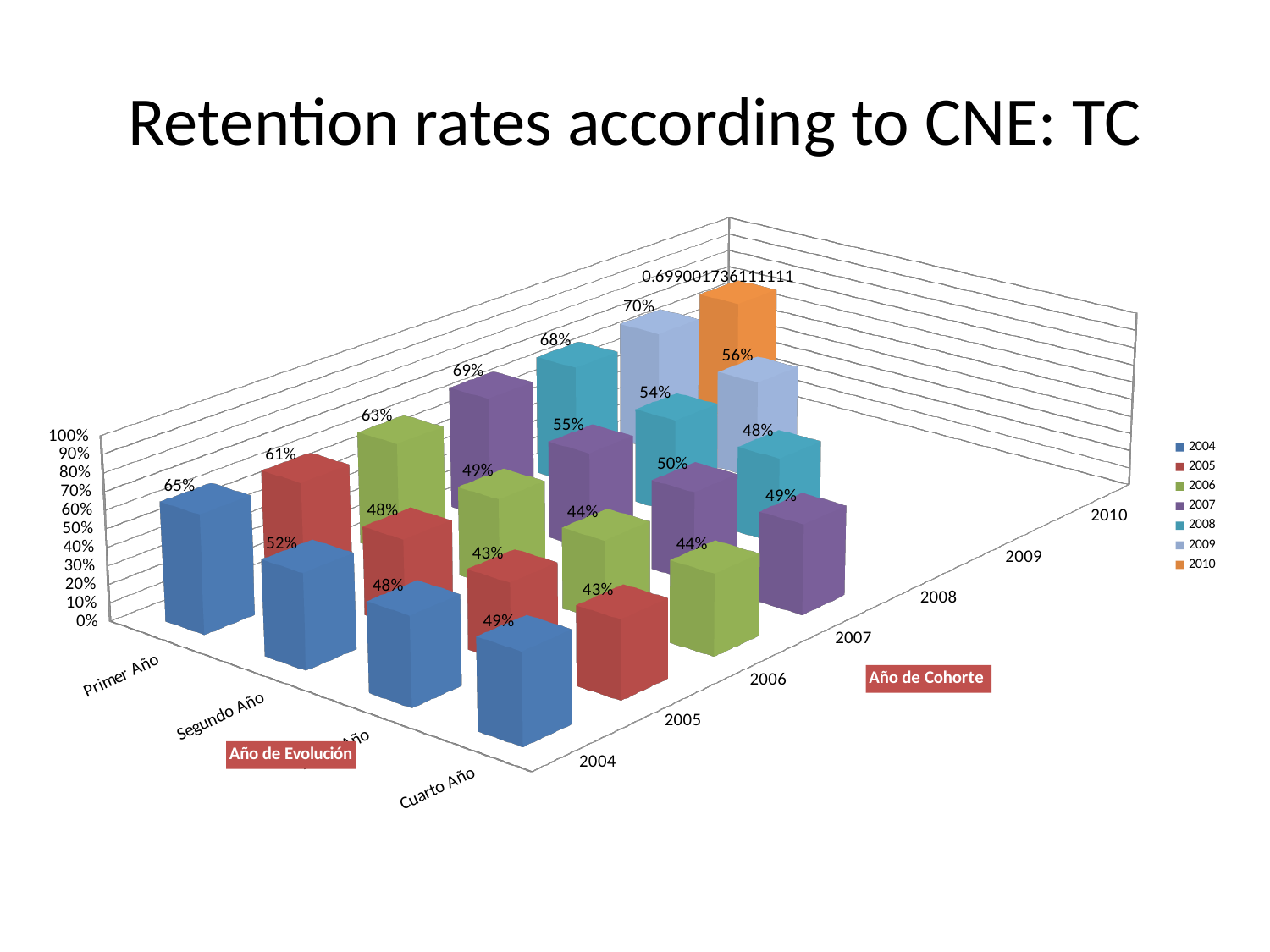
For the 2004 cohort, which Año de Evolución has the highest retention rate? Primer Año What kind of chart is shown on the slide? 3D bar chart What is the retention rate for the 2009 cohort in Primer Año? 70% What is the retention rate for the 2007 cohort in Segundo Año? 55% What is the retention rate for the 2004 cohort in Primer Año? 65% What is the title of the chart on the slide? Retention rates according to CNE: TC How many series does the legend list? 7 What is the difference between the 2004 cohort's retention rate in Primer Año and in Segundo Año? 13 percentage points In Primer Año, which cohort has the higher retention rate, 2007 or 2008? 2007 What is the retention rate for the 2005 cohort in Cuarto Año? 43% What data label is shown for the 2010 cohort in Primer Año? 0.699001736111111